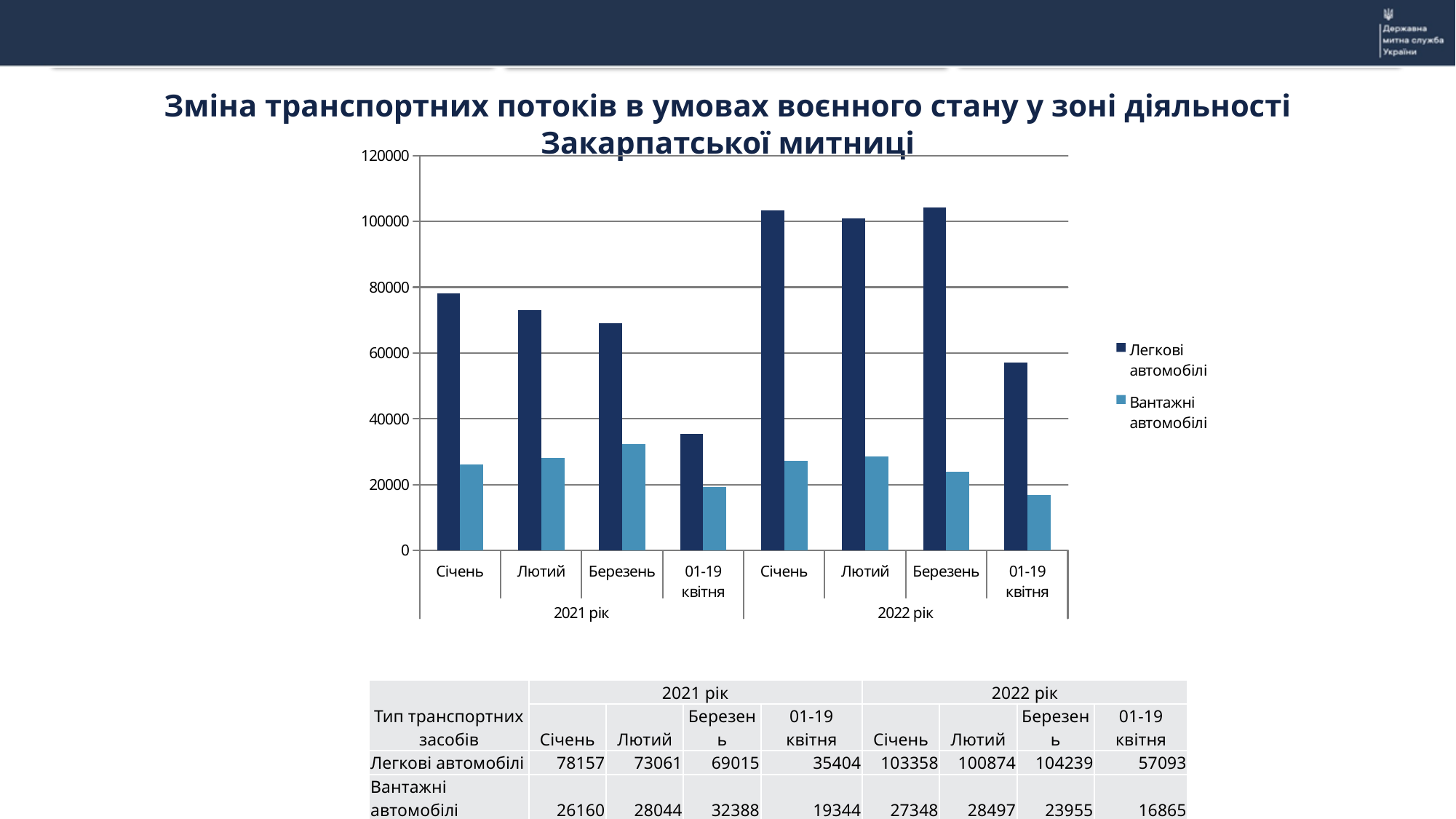
Which month has the highest value for Легкові автомобілі? Березень 2022 рік How many series does the legend list? 2 What kind of chart is shown on the slide? bar chart Which is larger: Вантажні автомобілі in Лютий 2021 рік or Лютий 2022 рік? Лютий 2022 рік What is the value for Легкові автомобілі in Січень 2021 рік? 78157 Which month has the highest value for Вантажні автомобілі? Березень 2021 рік What is the value for Вантажні автомобілі in Березень 2022 рік? 23955 Is the value for Легкові автомобілі in Лютий 2021 рік greater or less than 60000? greater Do the values for Легкові автомобілі rise or fall from Січень to 01-19 квітня in 2021 рік? fall What is the difference between Легкові автомобілі in Січень 2022 рік and Січень 2021 рік? 25201 Which month has the lowest value for Вантажні автомобілі? 01-19 квітня 2022 рік What is the value for Легкові автомобілі in 01-19 квітня 2022 рік? 57093